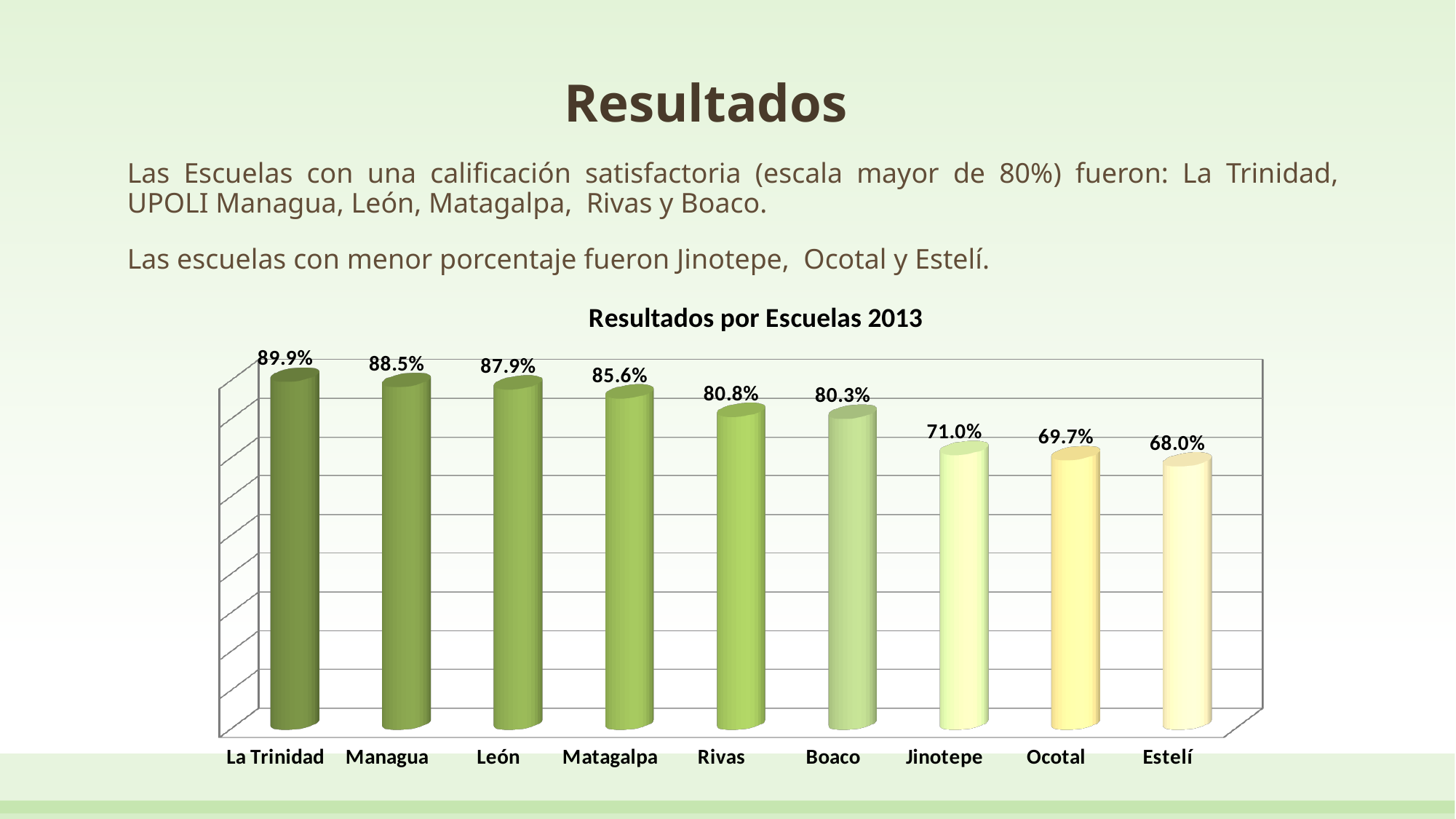
Which is larger, the value for Matagalpa or the value for Jinotepe? Matagalpa What is the value for Estelí? 68.0% Which school has the highest value? La Trinidad What is the difference between the values for La Trinidad and Estelí? 21.9% What is the difference between the values for Managua and León? 0.6% How many schools are shown on the chart? 9 What is the value for La Trinidad? 89.9% What kind of chart is shown? Bar chart Do the values rise or fall from left to right along the x axis? Fall What is the title of the chart? Resultados por Escuelas 2013 What is the value for Rivas? 80.8% Which school has the lowest value? Estelí